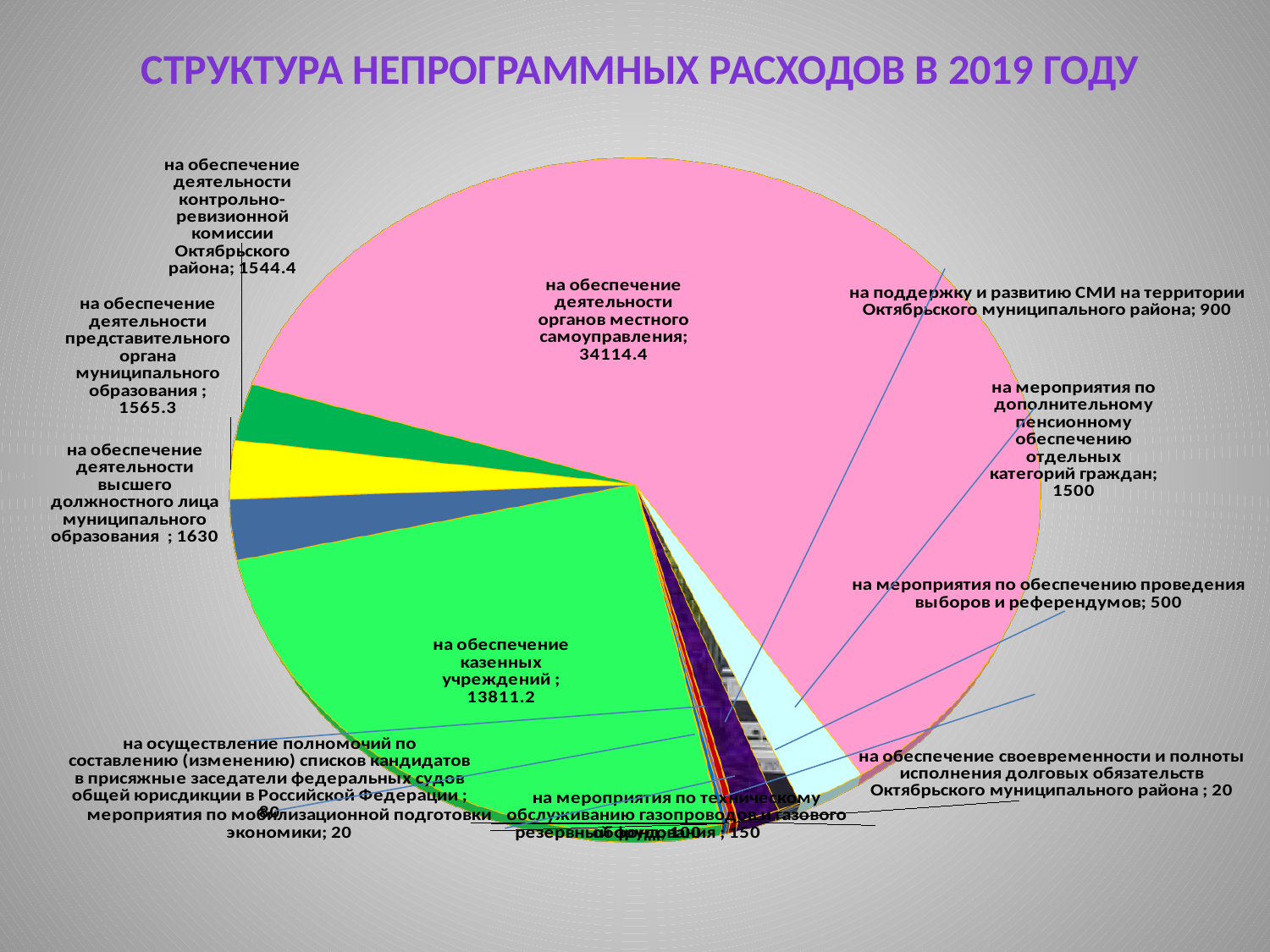
Which is larger: the value for "на обеспечение деятельности представительного органа муниципального образования" or for "на обеспечение деятельности контрольно-ревизионной комиссии Октябрьского района"? на обеспечение деятельности представительного органа муниципального образования Which category has the largest slice of the pie? на обеспечение деятельности органов местного самоуправления What is the value for "на мероприятия по обеспечению проведения выборов и референдумов"? 500 What is the value for "на обеспечение деятельности органов местного самоуправления"? 34114.4 What is the value for "на обеспечение казенных учреждений"? 13811.2 What is the value for "на поддержку и развитию СМИ на территории Октябрьского муниципального района"? 900 What is the value for "на обеспечение деятельности высшего должностного лица муниципального образования"? 1630 What is the title of the chart? СТРУКТУРА НЕПРОГРАММНЫХ РАСХОДОВ В 2019 ГОДУ What kind of chart is shown on the slide? pie chart What is the difference between the values for "на мероприятия по дополнительному пенсионному обеспечению отдельных категорий граждан" and "на поддержку и развитию СМИ на территории Октябрьского муниципального района"? 600 What is the difference between the values for "на обеспечение деятельности органов местного самоуправления" and "на обеспечение казенных учреждений"? 20303.2 What colour is the slice for "на обеспечение казенных учреждений"? green